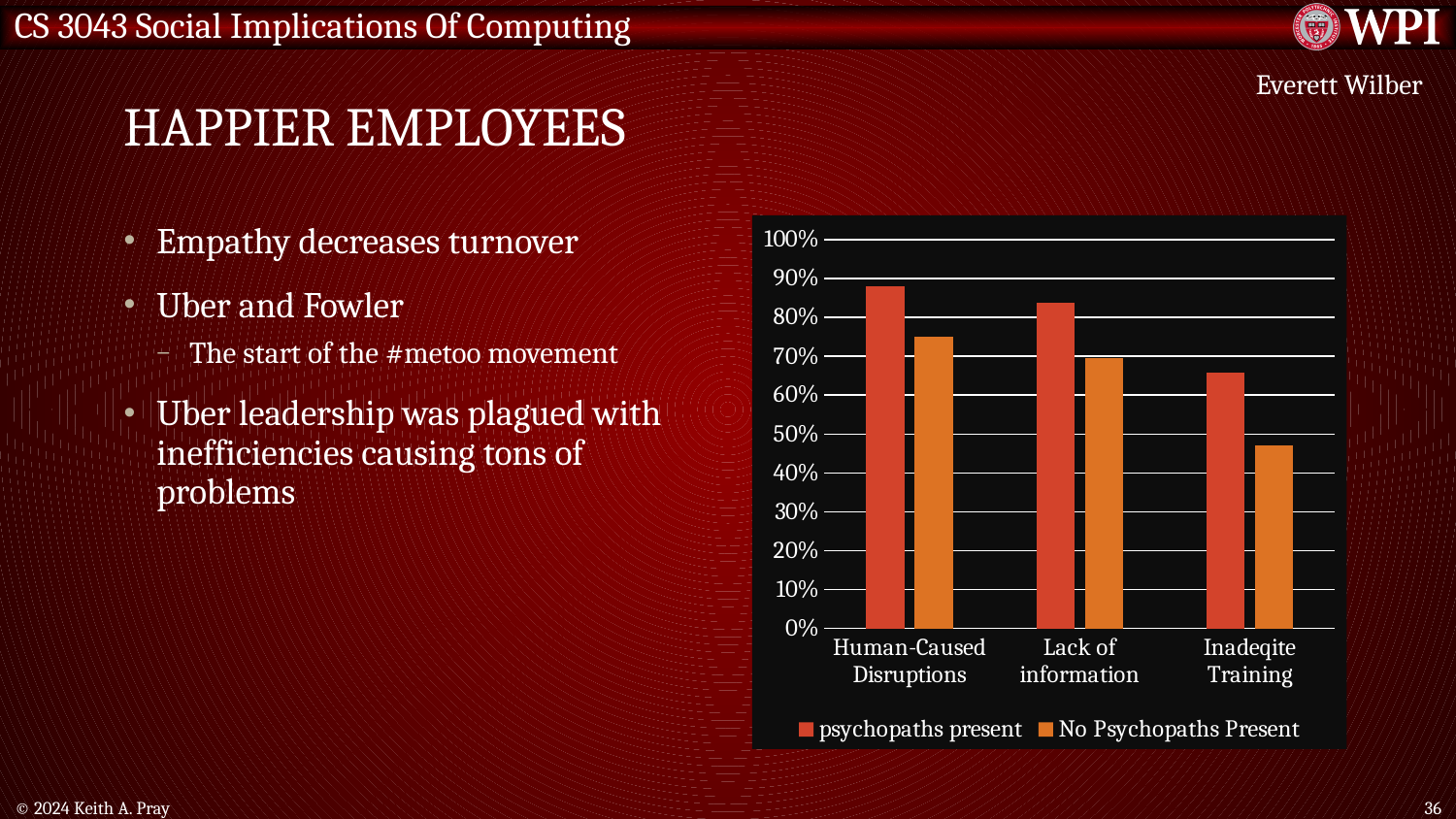
Do the 'psychopaths present' values rise or fall moving from left to right across the categories? fall Which category has the lowest value for the 'No Psychopaths Present' series? Inadeqite Training What is the second entry listed in the chart's legend? No Psychopaths Present Is the 'psychopaths present' value for Human-Caused Disruptions greater or less than 80%? greater Is the 'No Psychopaths Present' value for Lack of information greater or less than 60%? greater How many series does the chart's legend list? 2 Is the 'No Psychopaths Present' value for Inadeqite Training greater or less than 50%? less For Lack of information, which series has the larger value: 'psychopaths present' or 'No Psychopaths Present'? psychopaths present What kind of chart is shown on the slide? bar chart Which category has the highest value for the 'psychopaths present' series? Human-Caused Disruptions How many categories are shown on the x axis of the chart? 3